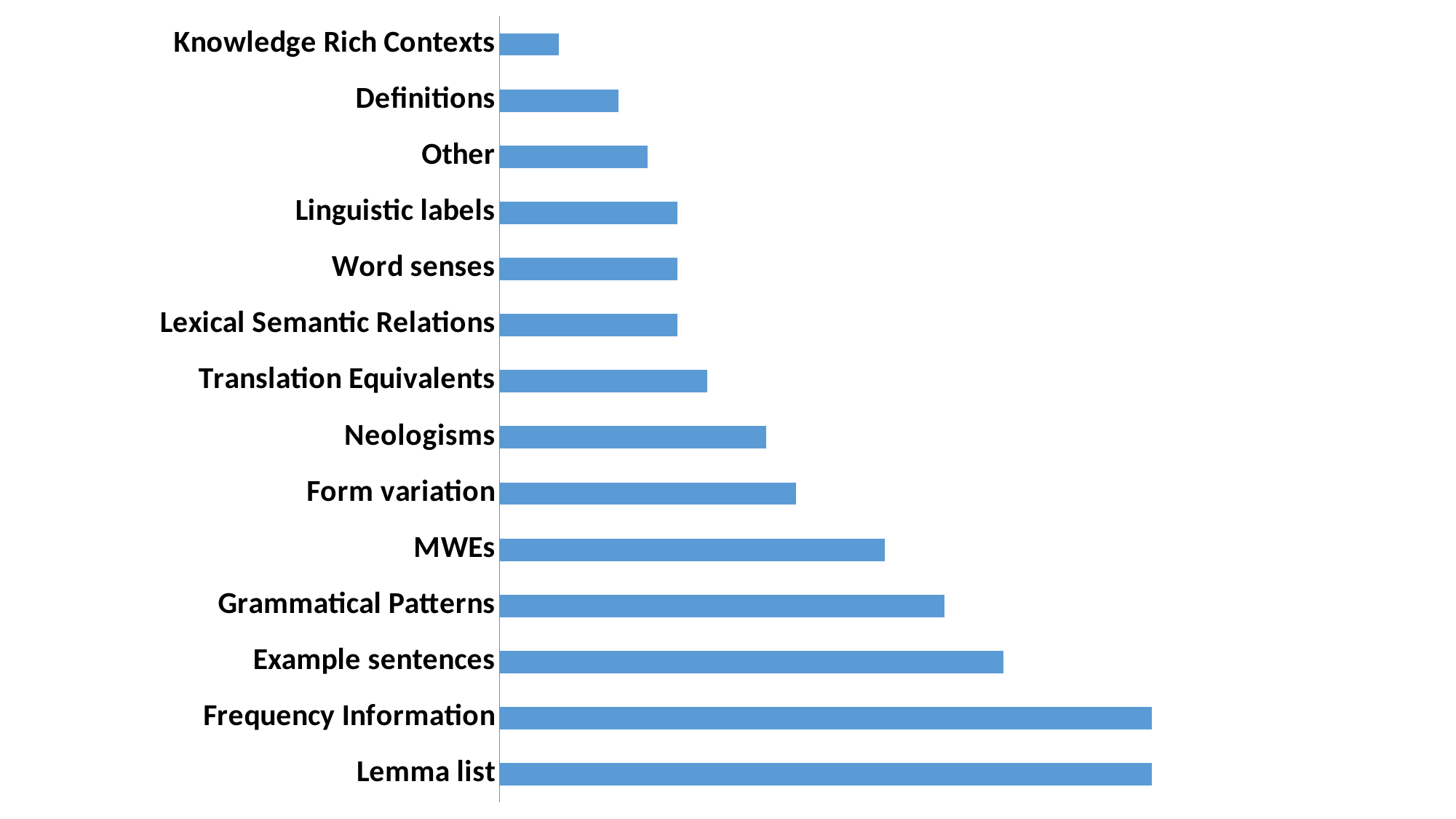
Which has the larger value, Neologisms or Translation Equivalents? Neologisms Which has the larger value, Grammatical Patterns or Form variation? Grammatical Patterns Which category has the shortest bar in the chart? Knowledge Rich Contexts Which category is listed at the bottom of the chart? Lemma list Which has the larger value, Definitions or Other? Other What kind of chart is shown on the slide? bar chart Do the bar lengths generally increase or decrease going from the top category to the bottom category? increase How many categories are plotted in the bar chart? 14 What colour are the bars in the chart? blue